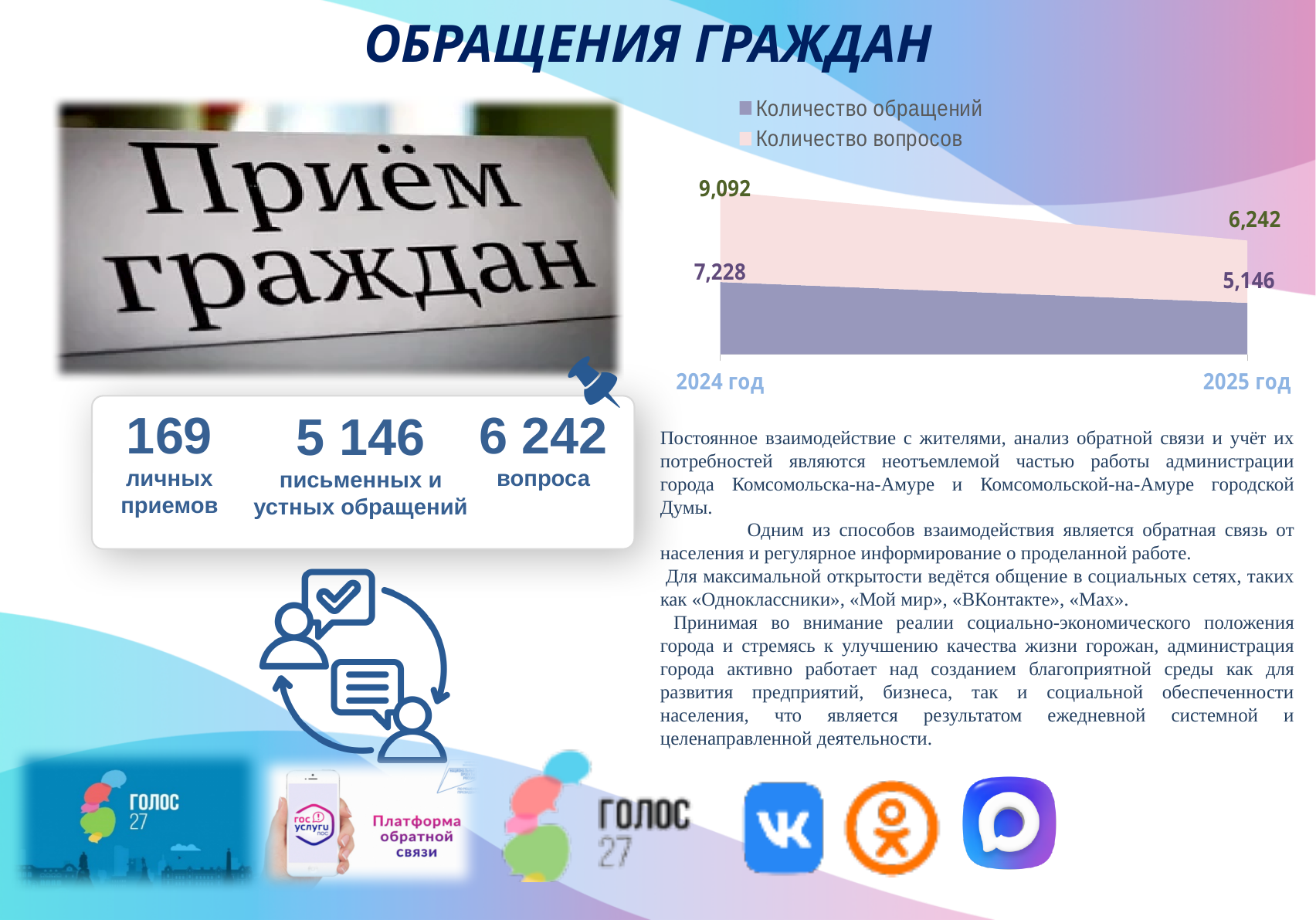
Do the values of «Количество вопросов» rise or fall from 2024 год to 2025 год? fall What is the value of «Количество обращений» for 2025 год? 5,146 By how much did «Количество обращений» decrease from 2024 год to 2025 год? 2,082 What is the value of «Количество обращений» for 2024 год? 7,228 Which is larger in 2025 год: «Количество обращений» or «Количество вопросов»? Количество вопросов What is the value of «Количество вопросов» for 2024 год? 9,092 How many series does the chart legend list? 2 By how much did «Количество вопросов» decrease from 2024 год to 2025 год? 2,850 What kind of chart is shown on the slide? area chart What is the value of «Количество вопросов» for 2025 год? 6,242 In which year is «Количество обращений» highest? 2024 год How many years (categories) are shown on the chart's x axis? 2